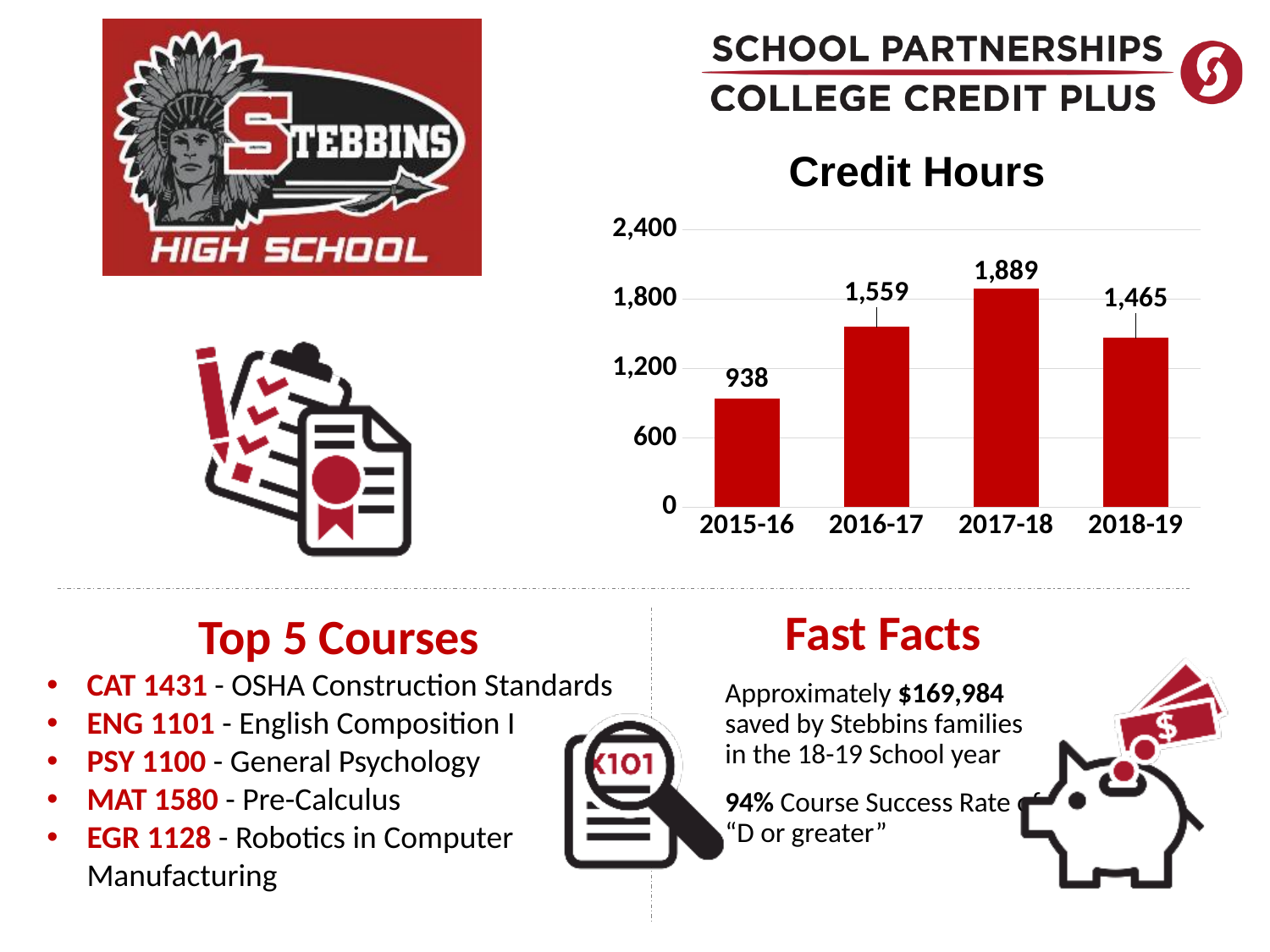
What is the value of credit hours for 2017-18? 1,889 What kind of chart is the Credit Hours chart? bar chart What is the value of credit hours for 2015-16? 938 How many school years are shown in the Credit Hours chart? 4 Which has more credit hours, 2016-17 or 2018-19? 2016-17 What is the title of the chart on the slide? Credit Hours What is the value of credit hours for 2018-19? 1,465 What is the difference in credit hours between 2017-18 and 2016-17? 330 What is the difference in credit hours between 2016-17 and 2015-16? 621 Which school year has the highest credit hours? 2017-18 Is the value for 2018-19 greater or less than 1,800? less Which school year has the lowest credit hours? 2015-16